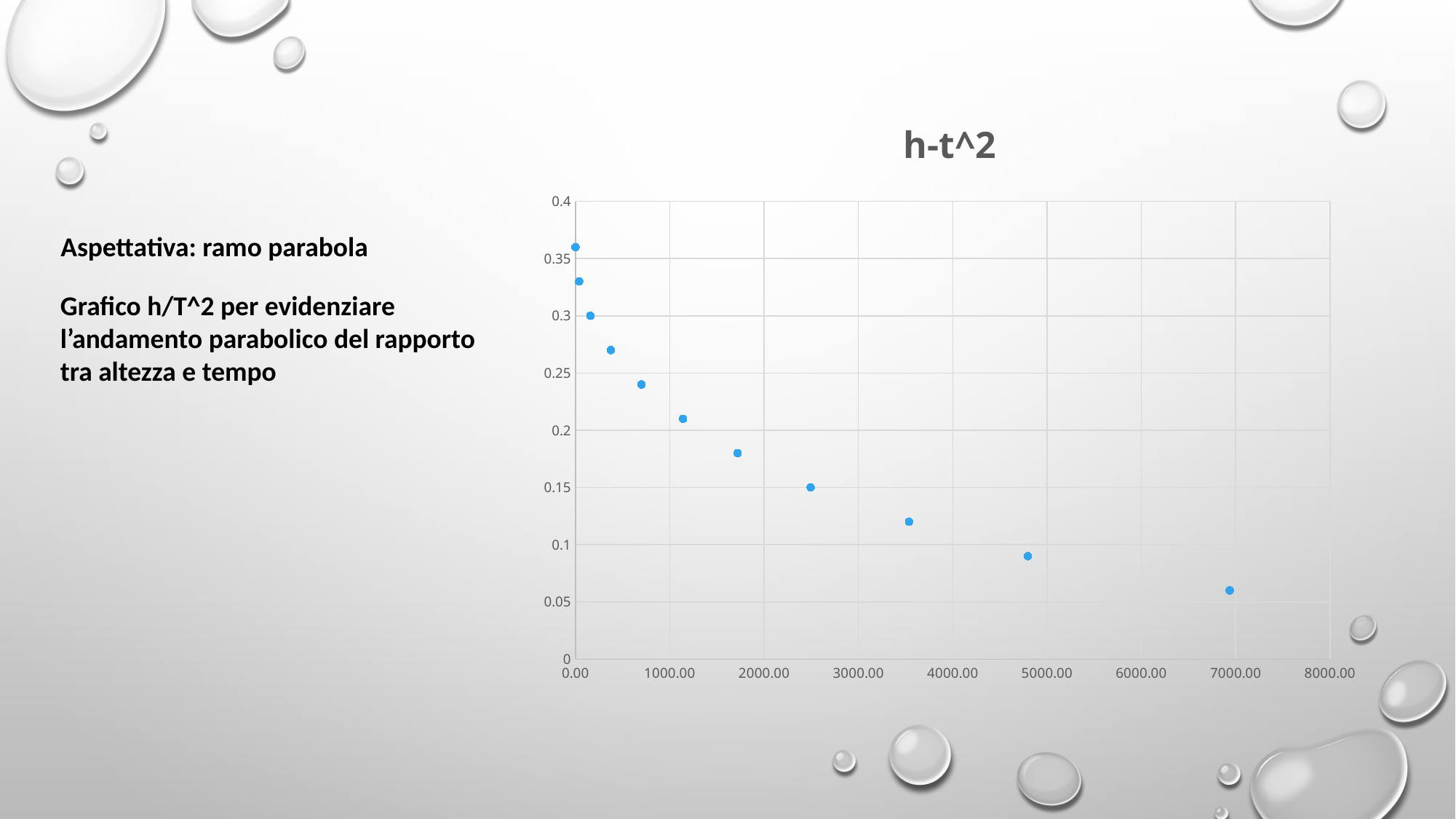
What is the title of the chart? h-t^2 Is the value of the rightmost point (near x = 7000.00) greater or less than 0.1? less Is the value of the point near x = 3500.00 greater or less than 0.1? greater Which point has the highest value: the leftmost point or the rightmost point? the leftmost point What is the highest value shown on the y axis? 0.4 Is the value of the point near x = 4800.00 greater or less than 0.1? less How many data points are plotted in the chart? 11 What kind of chart is shown on the slide? scatter chart Do the plotted values rise or fall as the x value increases? fall